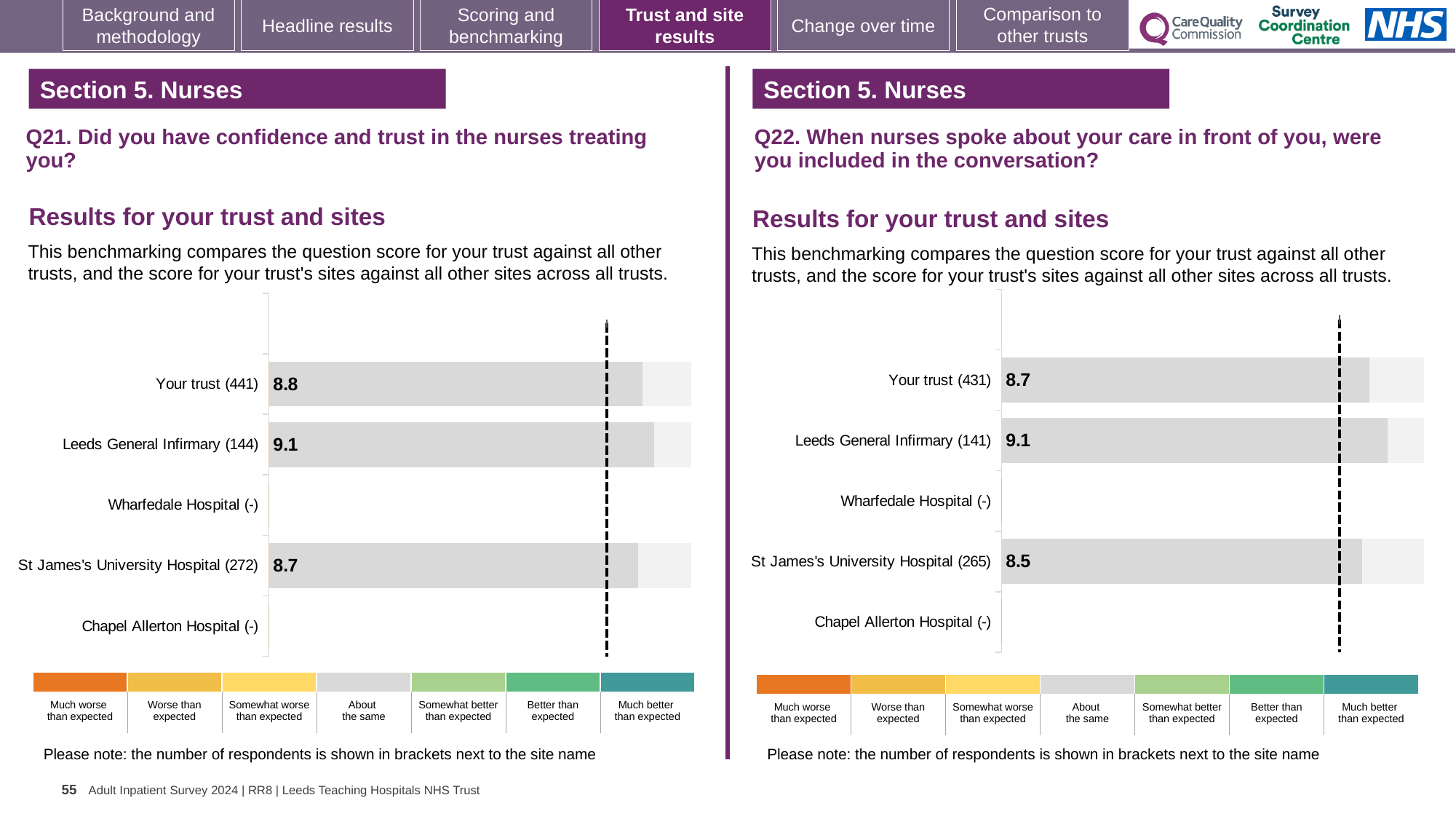
On the Q21 chart (left), how many categories are listed on the vertical axis? 5 On the Q21 chart (left), which of the plotted scores is the lowest? St James's University Hospital On the Q21 chart (left), what is the score for Leeds General Infirmary? 9.1 On the Q22 chart (right), which site or trust has the highest score? Leeds General Infirmary On the Q22 chart (right), what is the difference between the Leeds General Infirmary score and the St James's University Hospital score? 0.6 On the Q22 chart (right), what is the score for St James's University Hospital? 8.5 What kind of chart is used on the Q22 chart (right)? Bar chart On the Q21 chart (left), what is the score for St James's University Hospital? 8.7 On the Q21 chart (left), which is larger: the score for Leeds General Infirmary or the score for Your trust? Leeds General Infirmary On the Q22 chart (right), what is the score for Your trust? 8.7 On the Q21 chart (left), what is the score for Your trust? 8.8 On the Q22 chart (right), how many respondents are shown in brackets for Your trust? 431